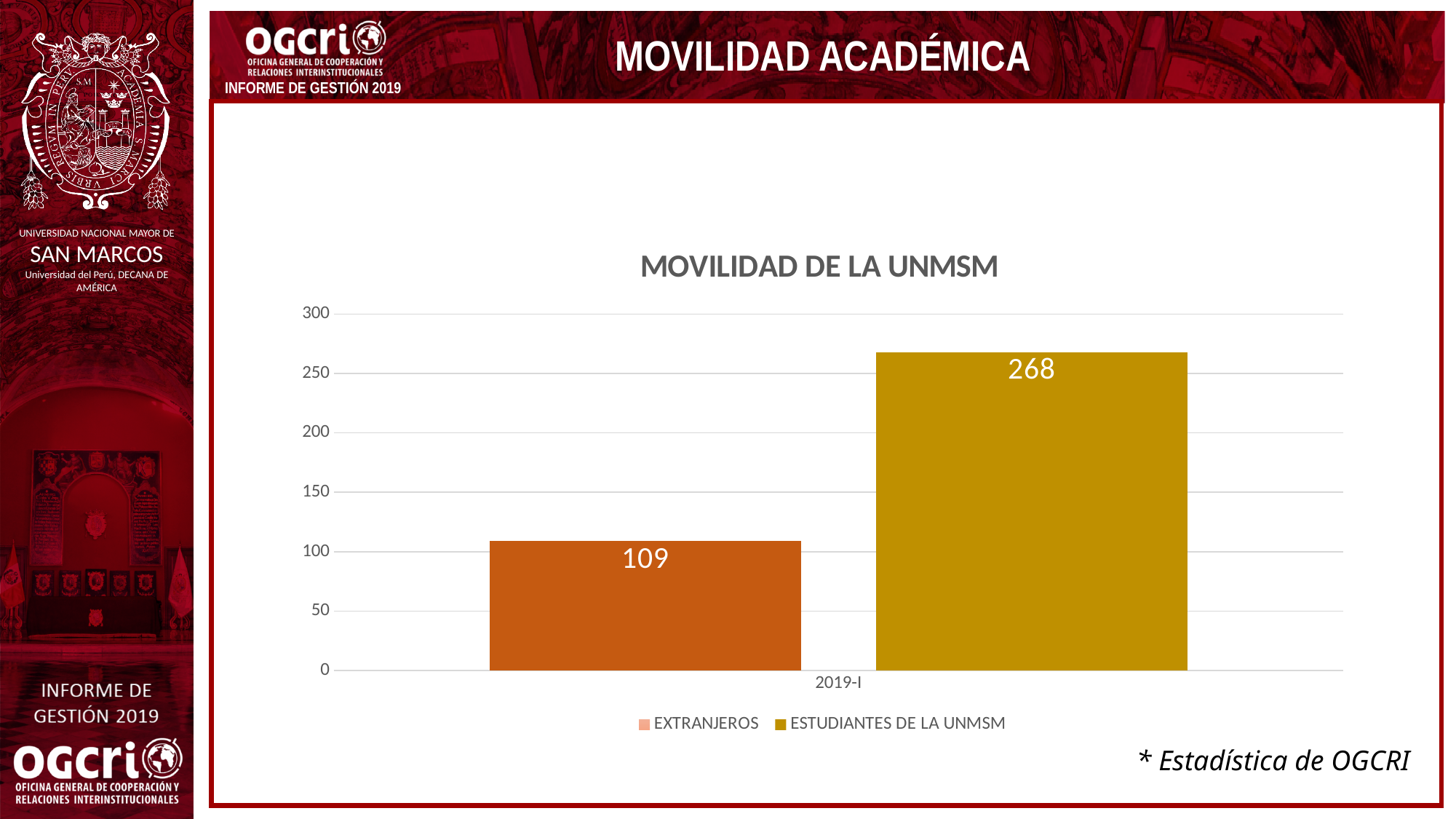
How many categories are shown on the x axis? 1 What kind of chart is shown? bar chart Is the value for EXTRANJEROS larger or smaller than the value for ESTUDIANTES DE LA UNMSM? smaller What is the value for EXTRANJEROS in 2019-I? 109 Is the value for ESTUDIANTES DE LA UNMSM greater or less than 250? greater What is the value for ESTUDIANTES DE LA UNMSM in 2019-I? 268 Which series has the higher value in 2019-I? ESTUDIANTES DE LA UNMSM What is the title of the chart? MOVILIDAD DE LA UNMSM Which series has the lower value in 2019-I? EXTRANJEROS How many series does the legend list? 2 Is the value for EXTRANJEROS greater or less than 150? less What is the difference between ESTUDIANTES DE LA UNMSM and EXTRANJEROS in 2019-I? 159